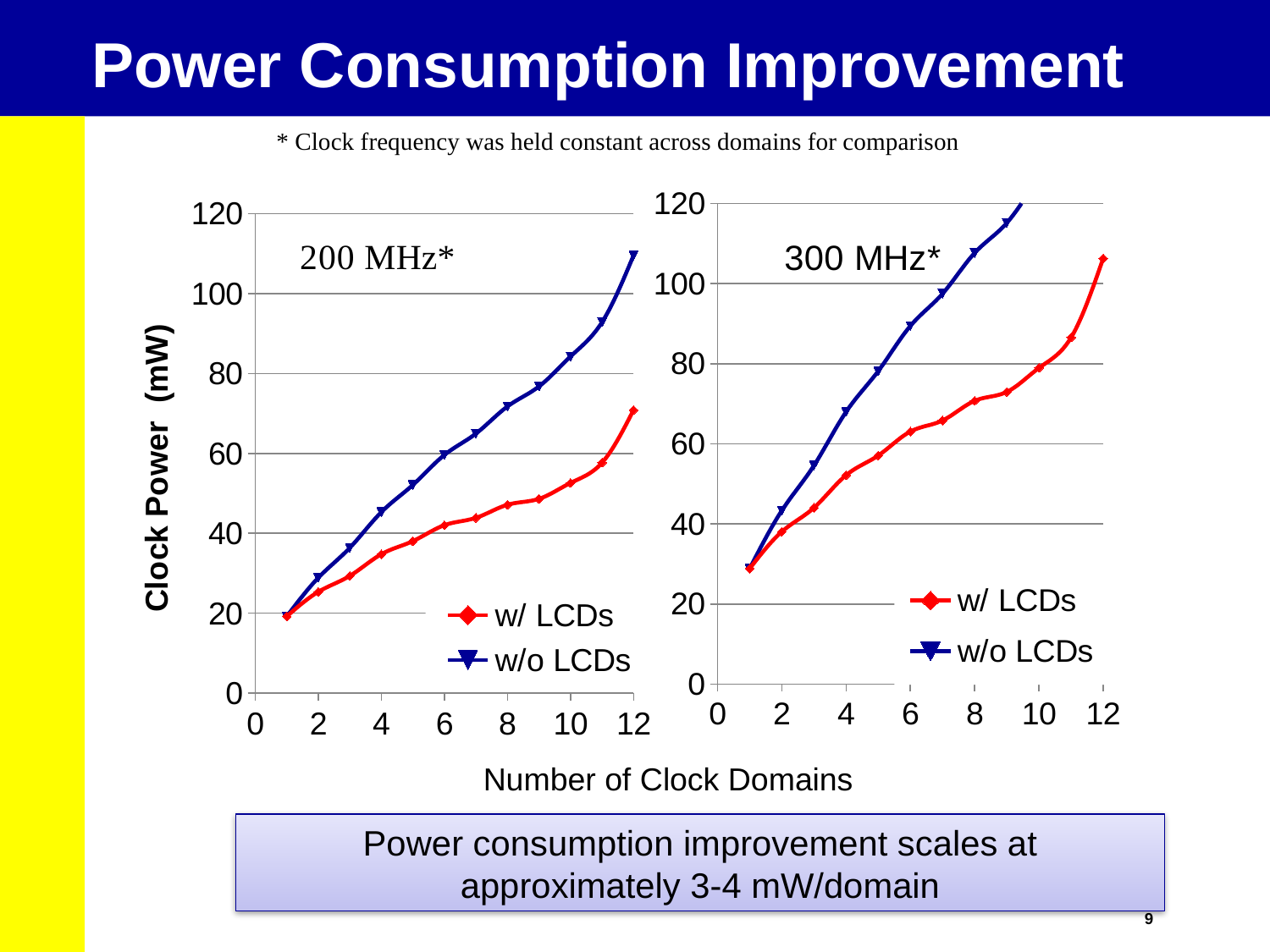
What kind of chart is the 200 MHz* chart on the left? line chart What is the label of the y axis on the 200 MHz* chart? Clock Power (mW) In the 200 MHz* chart, does the w/o LCDs series rise or fall as the number of clock domains increases? rise How many series does the legend of the 300 MHz* chart list? 2 In the 200 MHz* chart, is the w/o LCDs value at 12 clock domains greater or less than 100? greater In the 300 MHz* chart, is the w/ LCDs value at 12 clock domains greater or less than 100? greater What is the shared x-axis label below the two charts? Number of Clock Domains In the 200 MHz* chart, is the w/ LCDs value at 4 clock domains greater or less than 40? less In the 200 MHz* chart, which series has the higher value at 12 clock domains, w/ LCDs or w/o LCDs? w/o LCDs In the 300 MHz* chart, does the w/ LCDs series rise or fall as the number of clock domains increases? rise